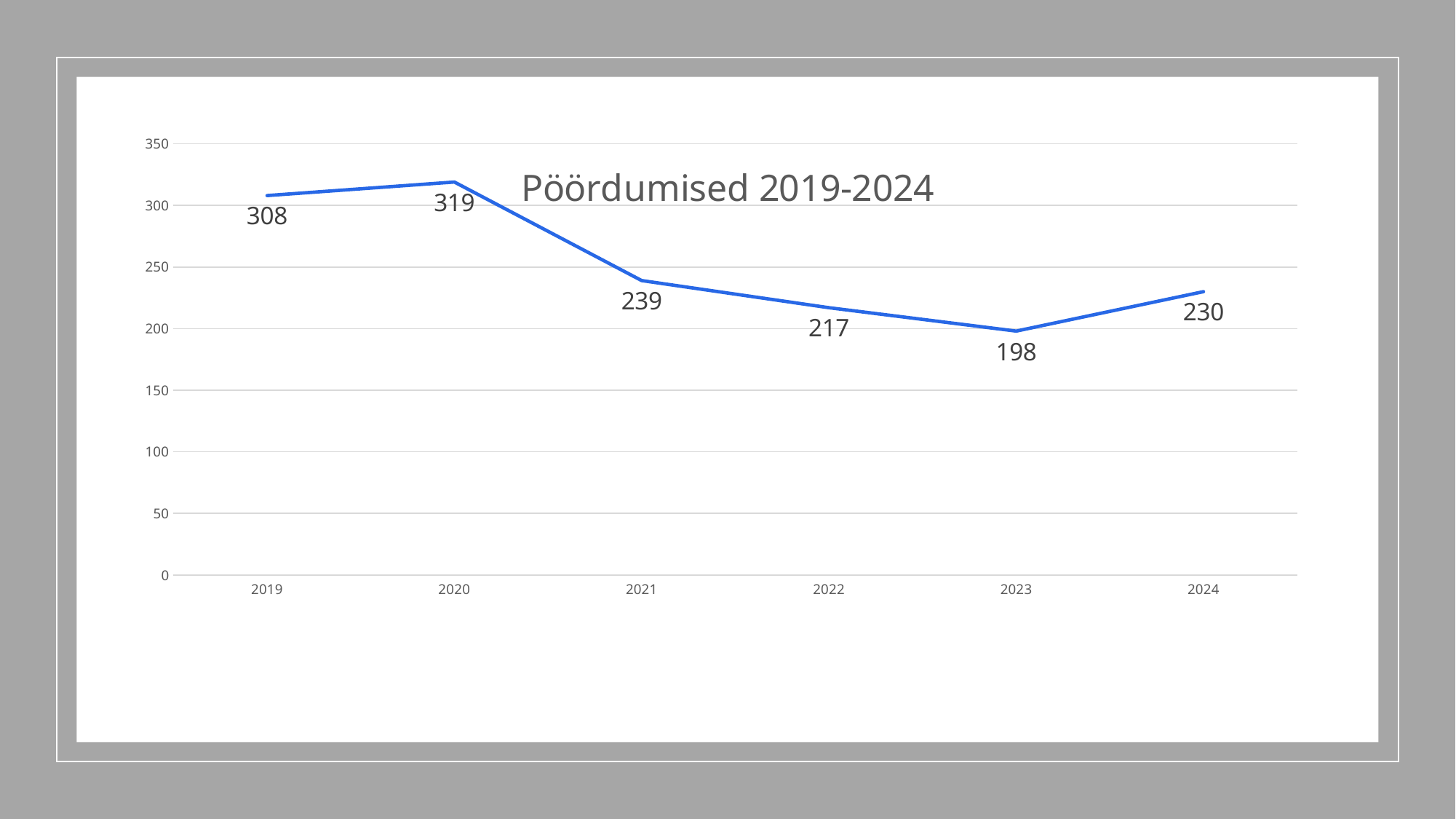
Which year has the lowest value? 2023 Is the value for 2023 greater or less than 200? less What is the title of the chart? Pöördumised 2019-2024 How many years are plotted on the chart? 6 What is the value for 2019? 308 What is the difference between the values for 2020 and 2021? 80 What kind of chart is shown on the slide? line chart What is the value for 2024? 230 What is the difference between the values for 2024 and 2023? 32 Which is larger, the value for 2021 or the value for 2024? 2021 What is the value for 2022? 217 Which year has the highest value? 2020